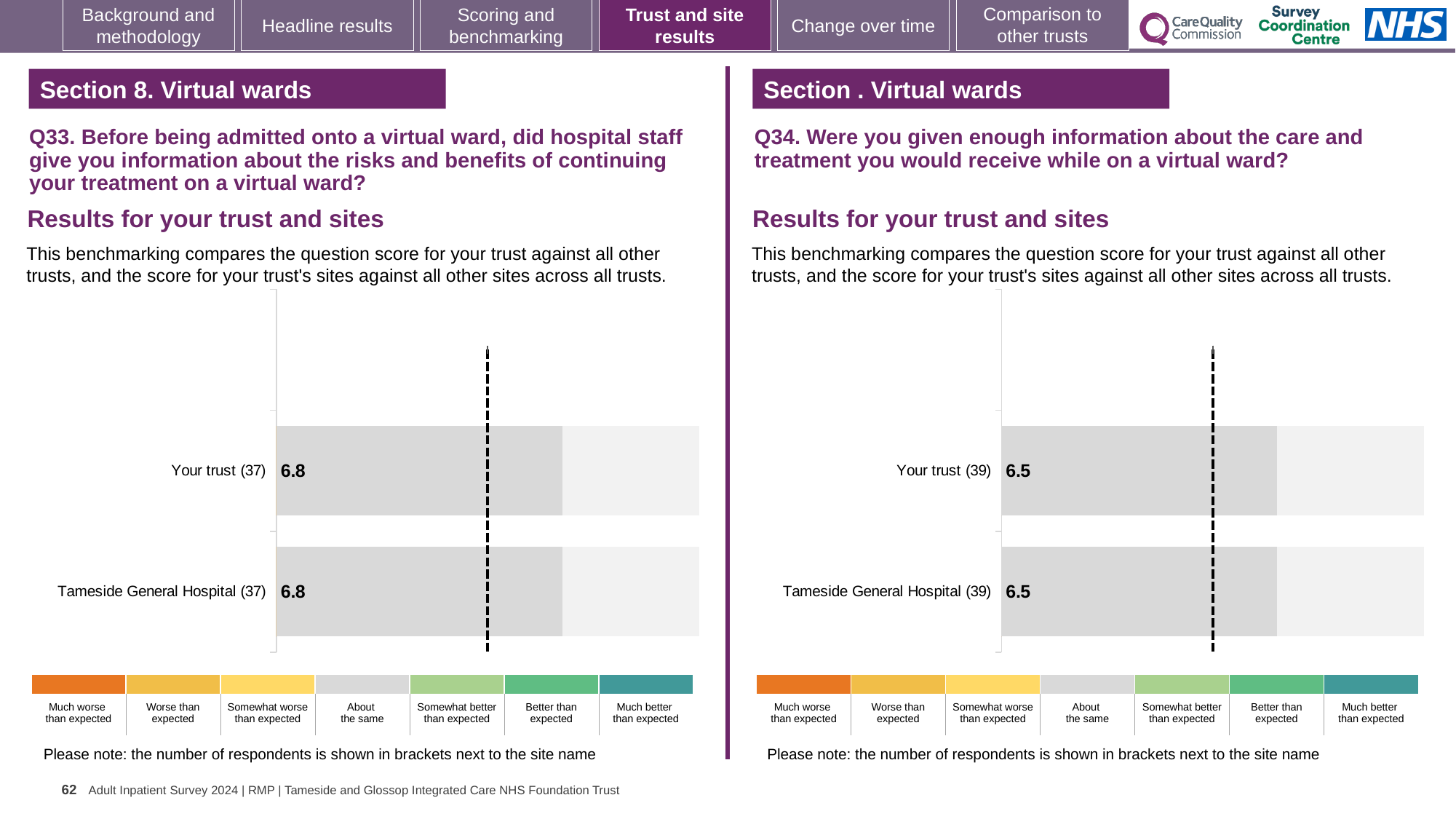
How many bars are plotted in the Q34 chart on the right? 2 In the Q33 chart on the left, what is the score for Your trust? 6.8 In the Q33 chart on the left, how many respondents are shown in brackets next to Your trust? 37 What is the difference between the Your trust score in the Q33 chart on the left and the Your trust score in the Q34 chart on the right? 0.3 Which is larger: the Your trust score in the Q33 chart on the left or the Your trust score in the Q34 chart on the right? Q33 chart (6.8) What kind of chart is used for the Q33 results on the left? Bar chart In the Q34 chart on the right, how many respondents are shown in brackets next to Tameside General Hospital? 39 In the Q34 chart on the right, what is the score for Tameside General Hospital? 6.5 In the Q33 chart on the left, what is the score for Tameside General Hospital? 6.8 How many bars are plotted in the Q33 chart on the left? 2 In the Q34 chart on the right, is the score for Your trust greater or less than the score for Tameside General Hospital, or are they equal? Equal In the Q34 chart on the right, what is the score for Your trust? 6.5